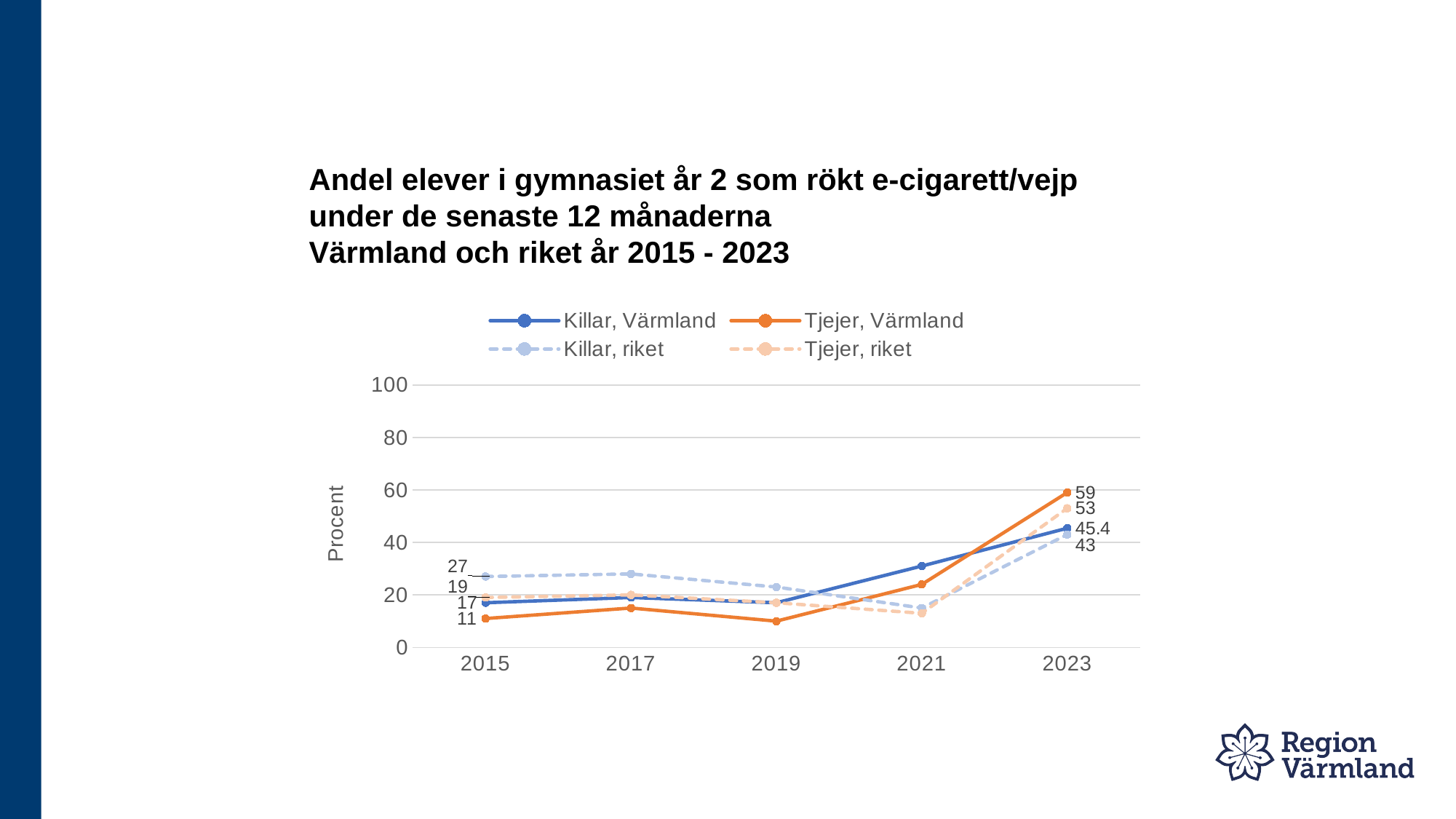
Is the value for Killar, Värmland in 2021 greater or less than 40? less Which series has the lowest value in 2015? Tjejer, Värmland What is the difference between Tjejer, Värmland and Killar, Värmland in 2023? 13.6 How many series does the legend list? 4 What is the value for Tjejer, Värmland in 2023? 59 What is the value for Killar, Värmland in 2015? 17 How many years are shown on the x axis? 5 What is the value for Killar, riket in 2015? 27 Which series has the highest value in 2023? Tjejer, Värmland What is the value for Tjejer, riket in 2023? 53 In 2023, which is larger: Killar, Värmland or Killar, riket? Killar, Värmland By how much did the value for Tjejer, Värmland increase from 2015 to 2023? 48